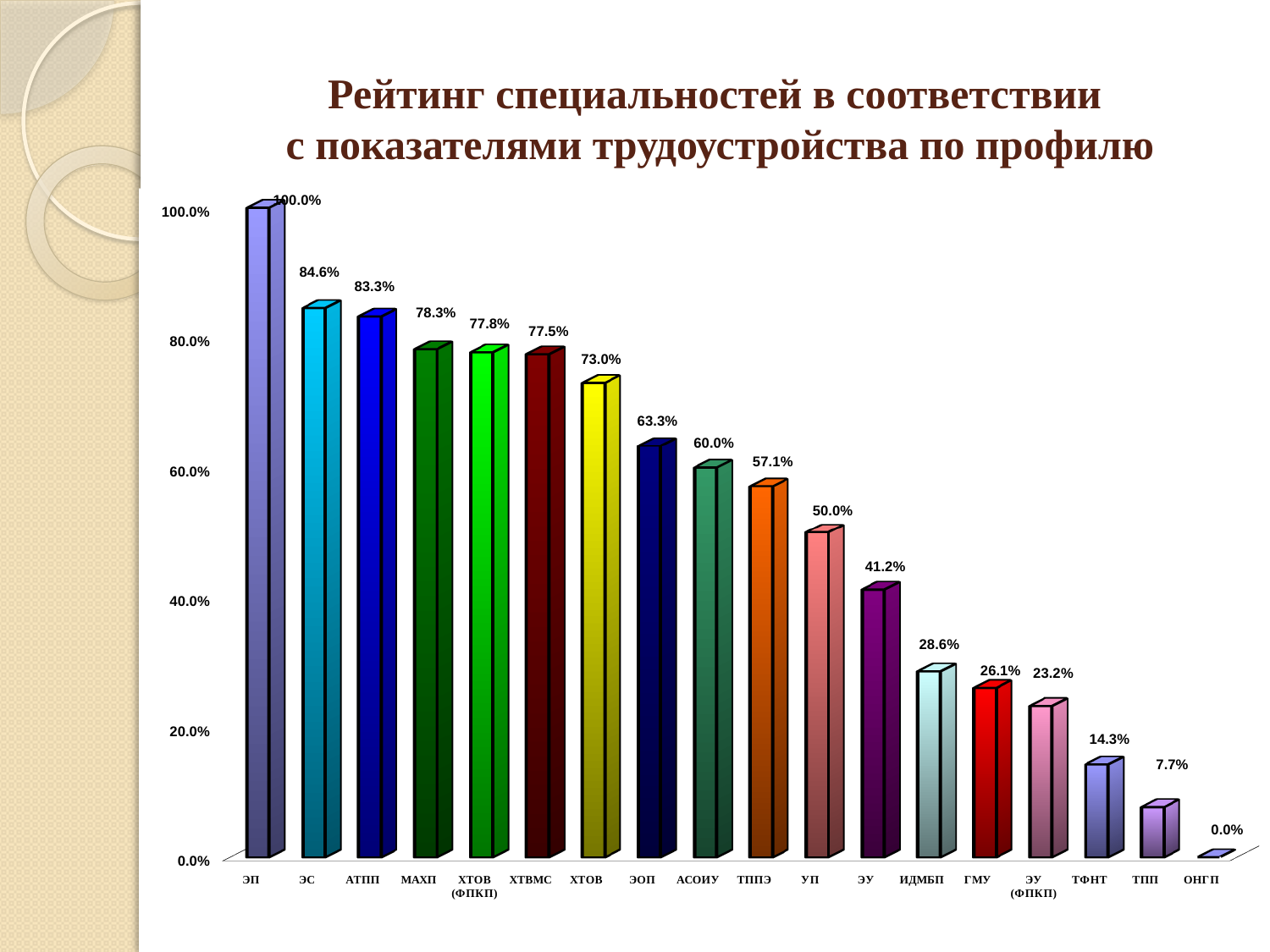
What is the value for УП? 50.0% Which category has the highest value? ЭП Which category has the lowest value? ОНГП What is the value for ИДМБП? 28.6% What is the difference between the values for ЭУ and ГМУ? 15.1% What kind of chart is shown on the slide? bar chart How many categories are shown on the x axis? 18 Which is larger, the value for ЭОП or the value for ТППЭ? ЭОП What is the difference between the values for АТПП and МАХП? 5.0% Is the value for ХТОВ greater or less than 60.0%? greater What is the value for ТФНТ? 14.3% What is the value for ЭС? 84.6%